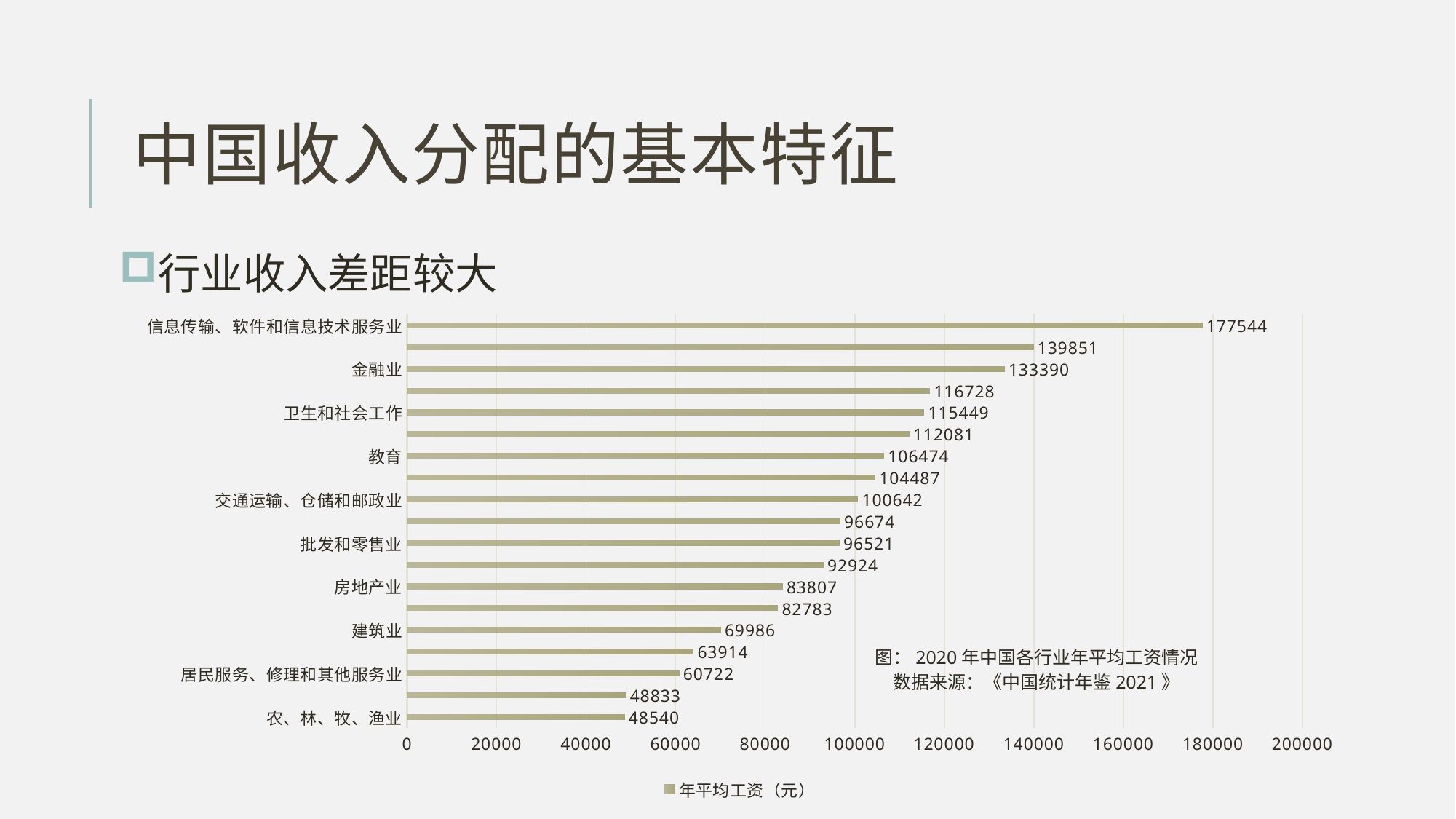
Which has a higher annual average wage, 卫生和社会工作 or 房地产业? 卫生和社会工作 What kind of chart is shown on the slide? Bar chart What is the annual average wage for 金融业? 133390 What is the annual average wage for 教育? 106474 What is the annual average wage for 信息传输、软件和信息技术服务业? 177544 Which industry has the lowest annual average wage? 农、林、牧、渔业 What is the annual average wage for 农、林、牧、渔业? 48540 How many series does the legend list? 1 What is the difference between the annual average wage of 信息传输、软件和信息技术服务业 and 农、林、牧、渔业? 129004 Which industry has the highest annual average wage? 信息传输、软件和信息技术服务业 How many bars are plotted in the chart? 19 What is the legend entry of the chart? 年平均工资（元）